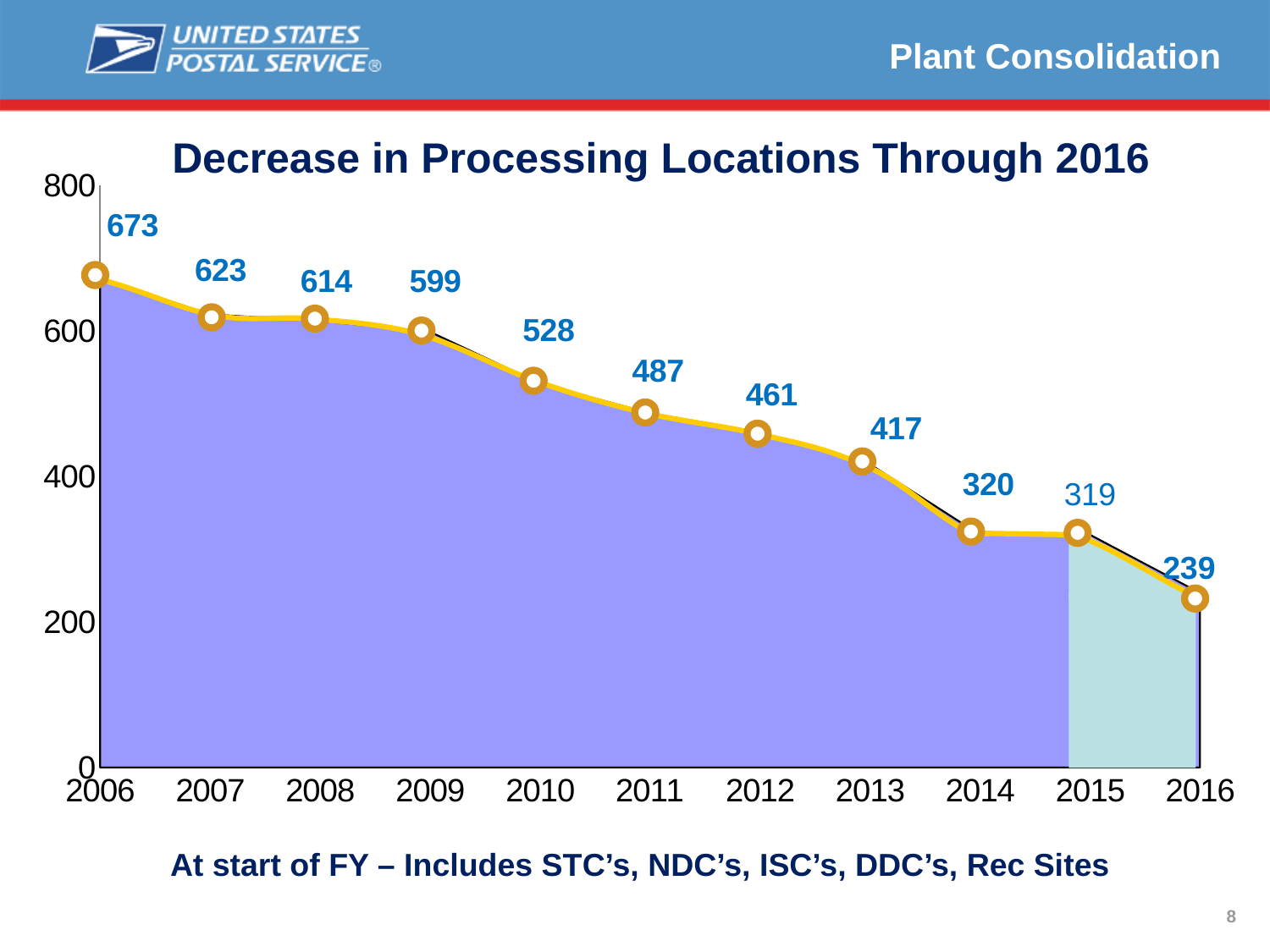
What is the title of the chart? Decrease in Processing Locations Through 2016 What is the difference in processing locations between 2013 and 2014? 97 What is the number of processing locations in 2010? 528 Which year has the highest number of processing locations? 2006 Which year has the lowest number of processing locations? 2016 What is the number of processing locations in 2006? 673 What is the number of processing locations in 2016? 239 How many years are plotted on the chart? 11 Which year has more processing locations, 2009 or 2011? 2009 What kind of chart is shown on the slide? Area chart What is the difference in processing locations between 2006 and 2016? 434 Do the values rise or fall from 2006 to 2016? Fall